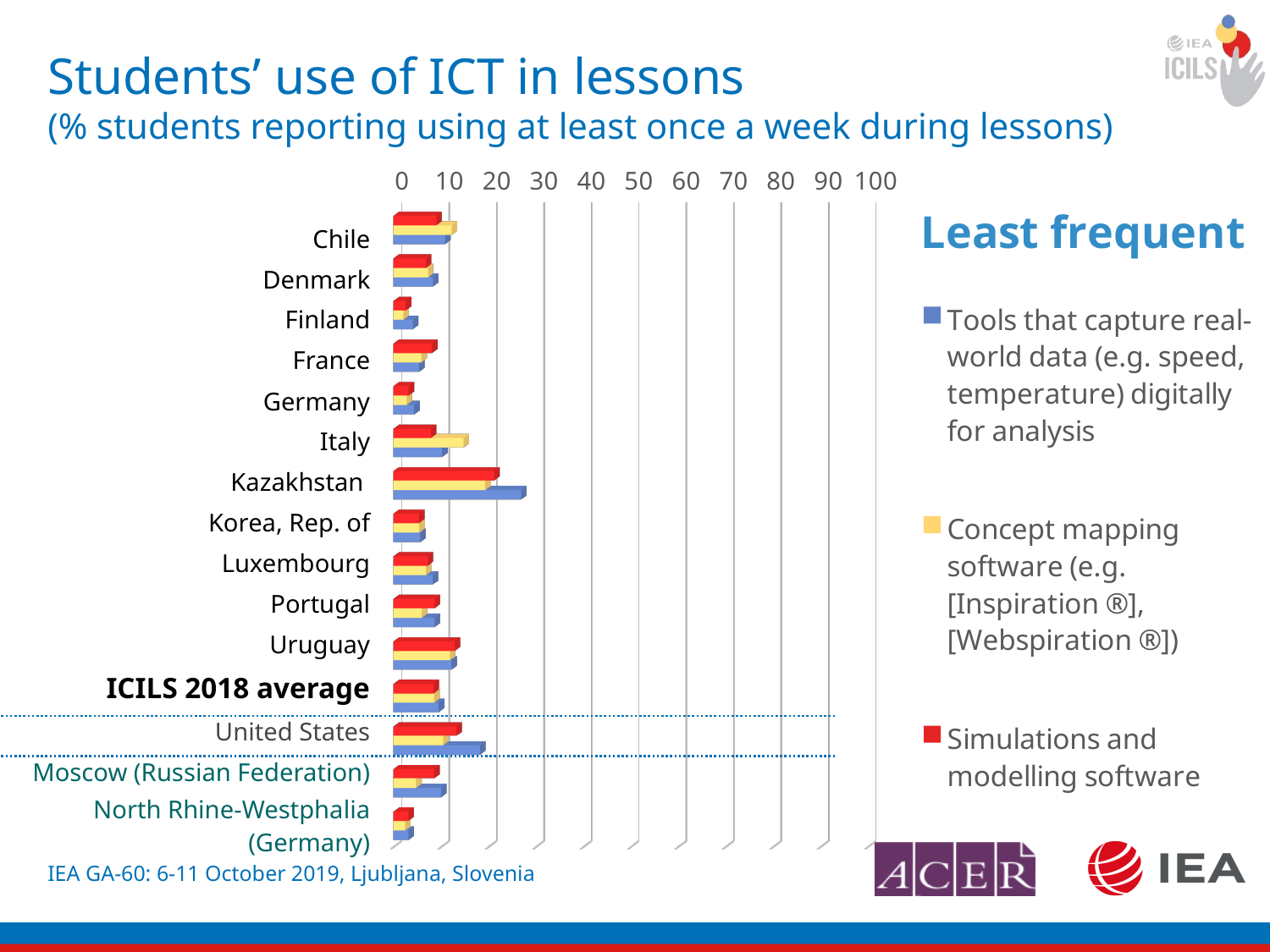
How many categories (countries/regions and averages) are plotted on the chart? 15 Which category has the highest value for 'Simulations and modelling software'? Kazakhstan How many series does the legend list? 3 Is the value for Finland for 'Tools that capture real-world data' greater or less than 10? less Which colour represents 'Simulations and modelling software' in the legend? red Which is larger for 'Tools that capture real-world data': Kazakhstan or Finland? Kazakhstan Which category has the highest value for 'Tools that capture real-world data'? Kazakhstan Is the value for Kazakhstan for 'Tools that capture real-world data' greater or less than 20? greater Is the value for the United States for 'Tools that capture real-world data' greater or less than 10? greater What kind of chart is shown on the slide? bar chart Which is larger for 'Concept mapping software': Italy or Germany? Italy